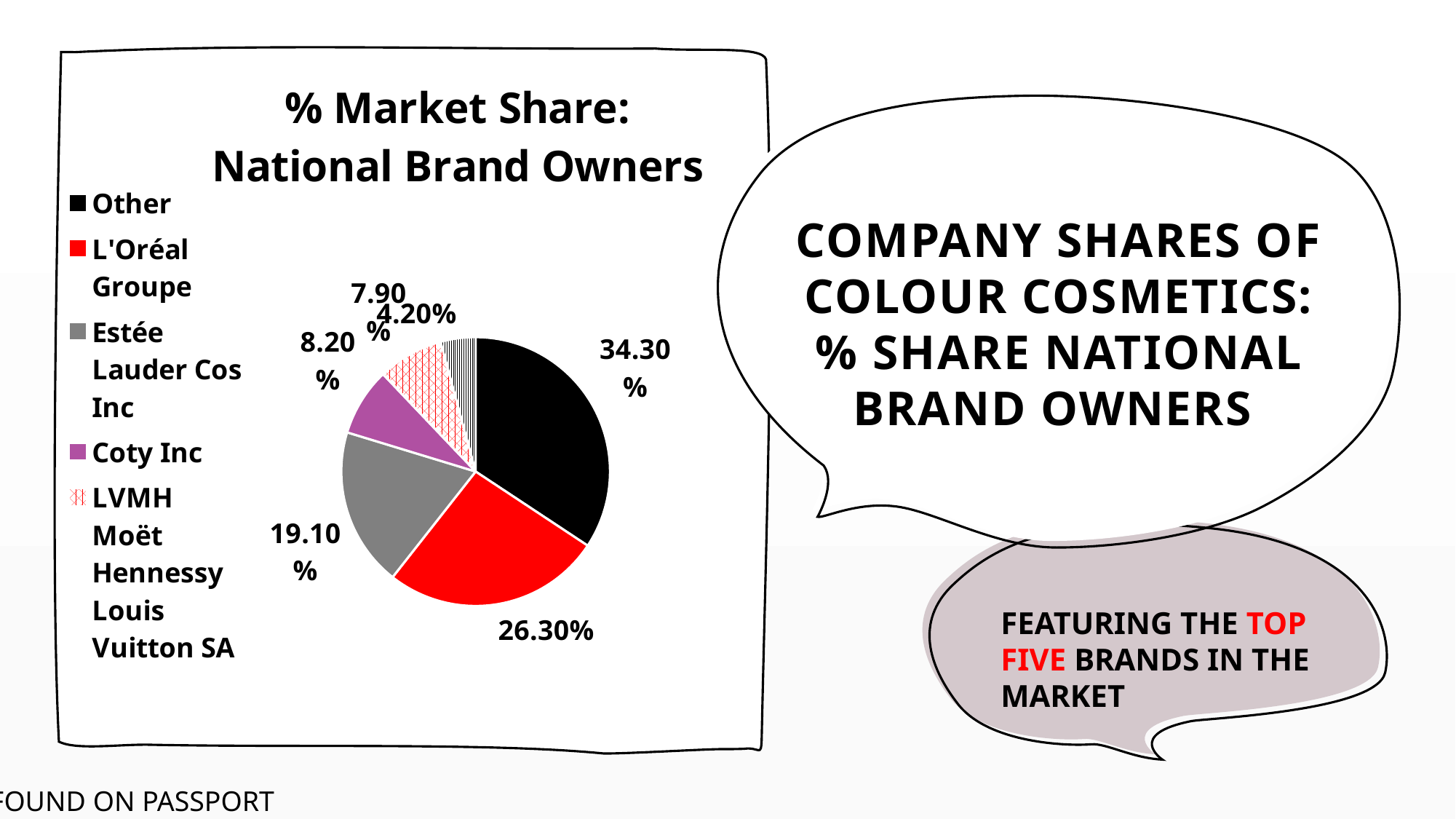
Which has the larger share, L'Oréal Groupe or Estée Lauder Cos Inc? L'Oréal Groupe Which category has the largest slice of the pie? Other What is the title of the chart? % Market Share: National Brand Owners How many entries does the legend list? 5 What is the market share for Coty Inc? 8.20% What colour is the slice for Other? black What is the market share for Estée Lauder Cos Inc? 19.10% How much larger is L'Oréal Groupe's share than Estée Lauder Cos Inc's share? 7.20% What is the market share for L'Oréal Groupe? 26.30% What is the market share for Other? 34.30% What kind of chart is shown on the slide? pie chart What is the market share for LVMH Moët Hennessy Louis Vuitton SA? 7.90%